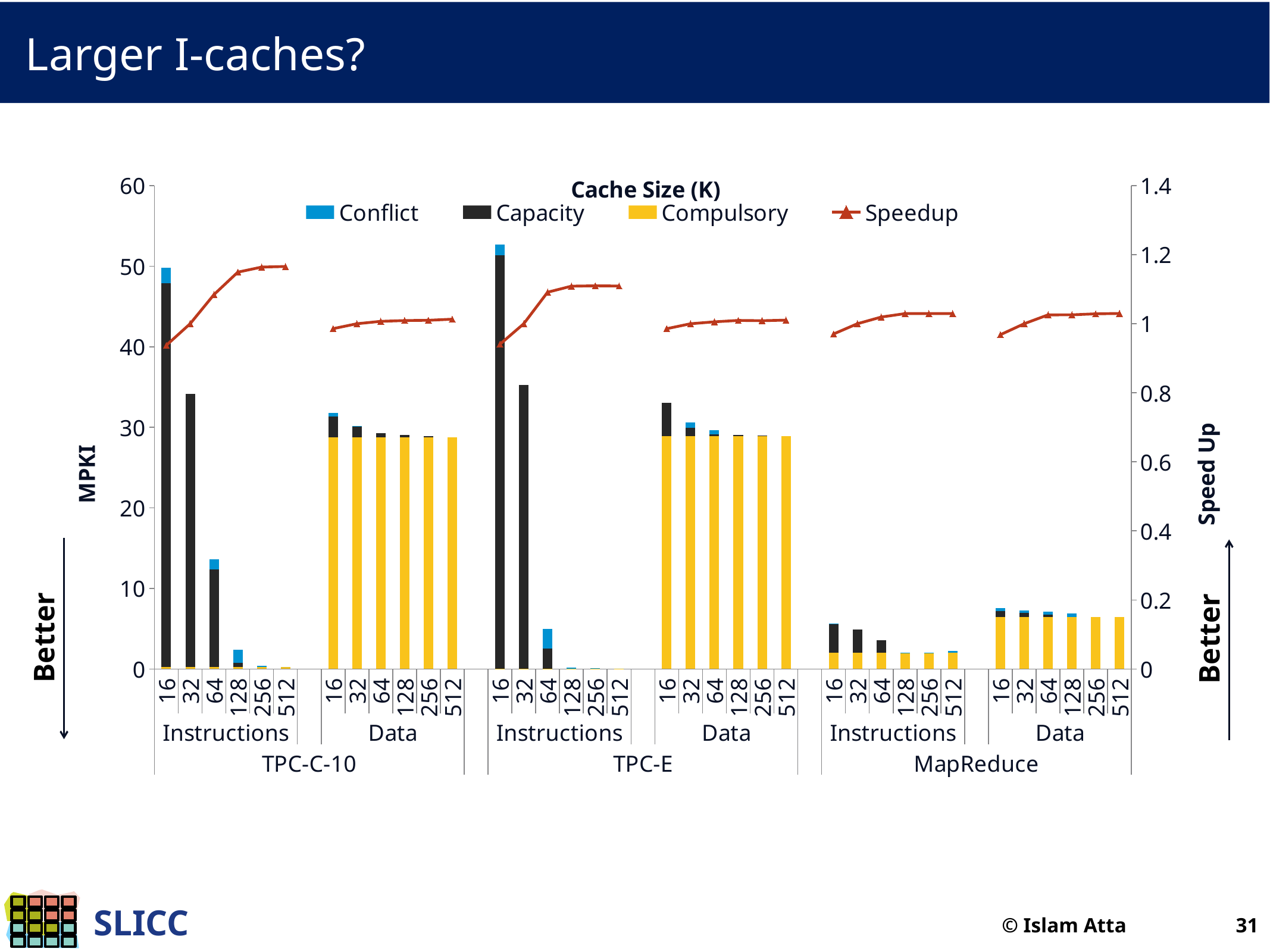
Is the Speedup for TPC-C-10 Instructions at 512K greater or less than 1? greater Is the total MPKI for TPC-C-10 Instructions at 16K greater or less than 40? greater Is the total MPKI for MapReduce Instructions at 16K greater or less than 10? less How does the Speedup line for TPC-C-10 Instructions change as cache size increases from 16K to 512K? It rises Within TPC-C-10 Instructions, which cache size has the highest total MPKI? 16 How many workloads are shown along the x axis? 3 What kind of chart is shown on the slide? Stacked bar chart with a line (Speedup) overlay How many cache sizes are plotted for each Instructions or Data group? 6 Which has the larger total MPKI: TPC-C-10 Instructions at 32K or TPC-C-10 Instructions at 64K? TPC-C-10 Instructions at 32K How many series does the legend list? 4 What is the title of the left vertical axis? MPKI